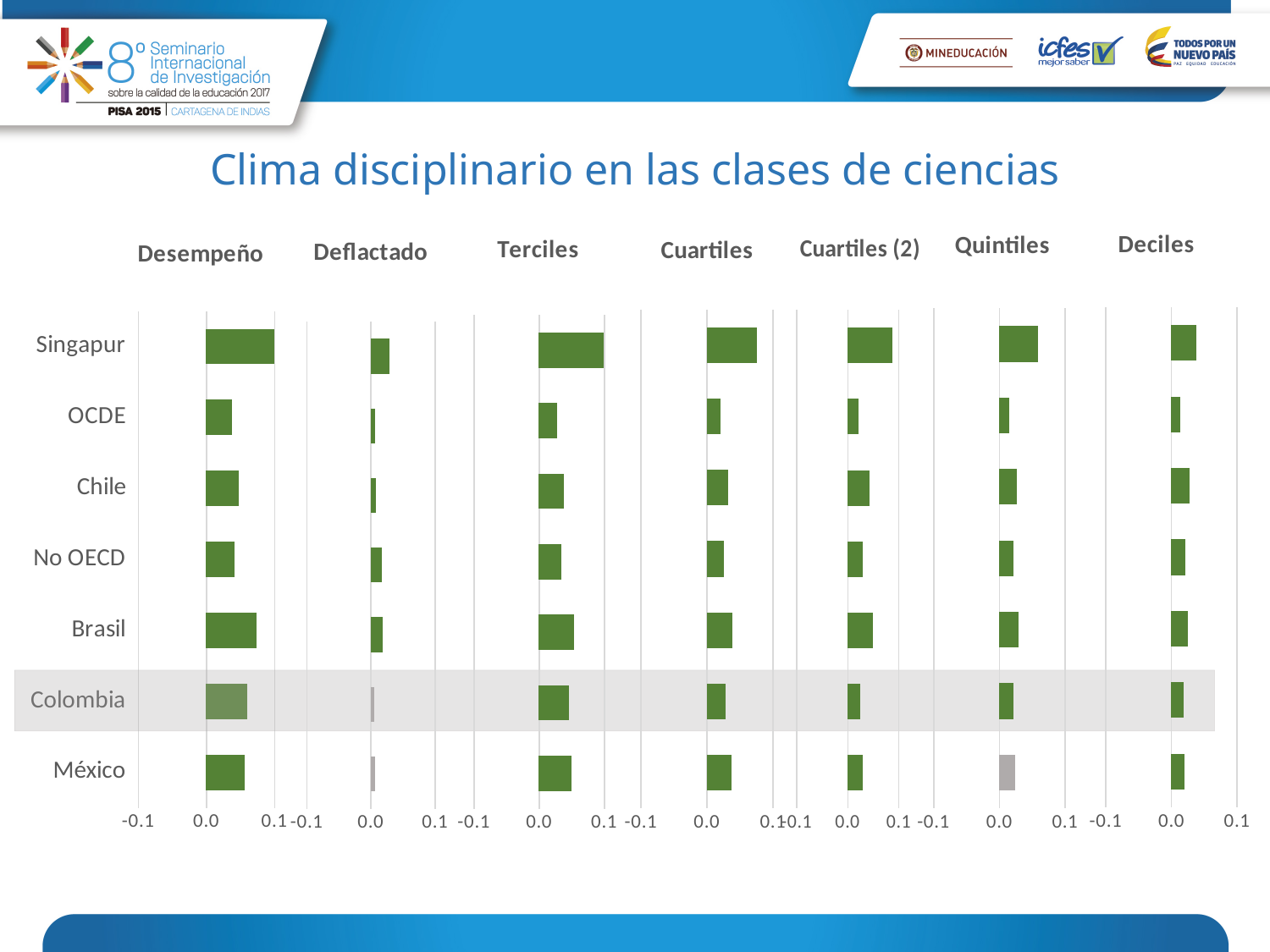
What is the title of the slide above the charts? Clima disciplinario en las clases de ciencias In the Cuartiles chart, which category has the highest value? Singapur How many separate bar charts are shown on the slide? 7 In the Desempeño chart, which category has the highest value? Singapur In the Desempeño chart, which is larger, the value for Brasil or the value for OCDE? Brasil In the Deflactado chart, is the value for Singapur greater or less than 0.1? less In the Terciles chart, which category has the highest value? Singapur How many countries or groups are listed as categories in the Desempeño chart? 7 In the Terciles chart, which is larger, the value for Singapur or the value for Chile? Singapur What kind of chart is used for the Desempeño panel? bar chart In the Desempeño chart, is the value for Singapur greater or less than 0.0? greater In the Quintiles chart, is the value for Singapur greater or less than 0.0? greater